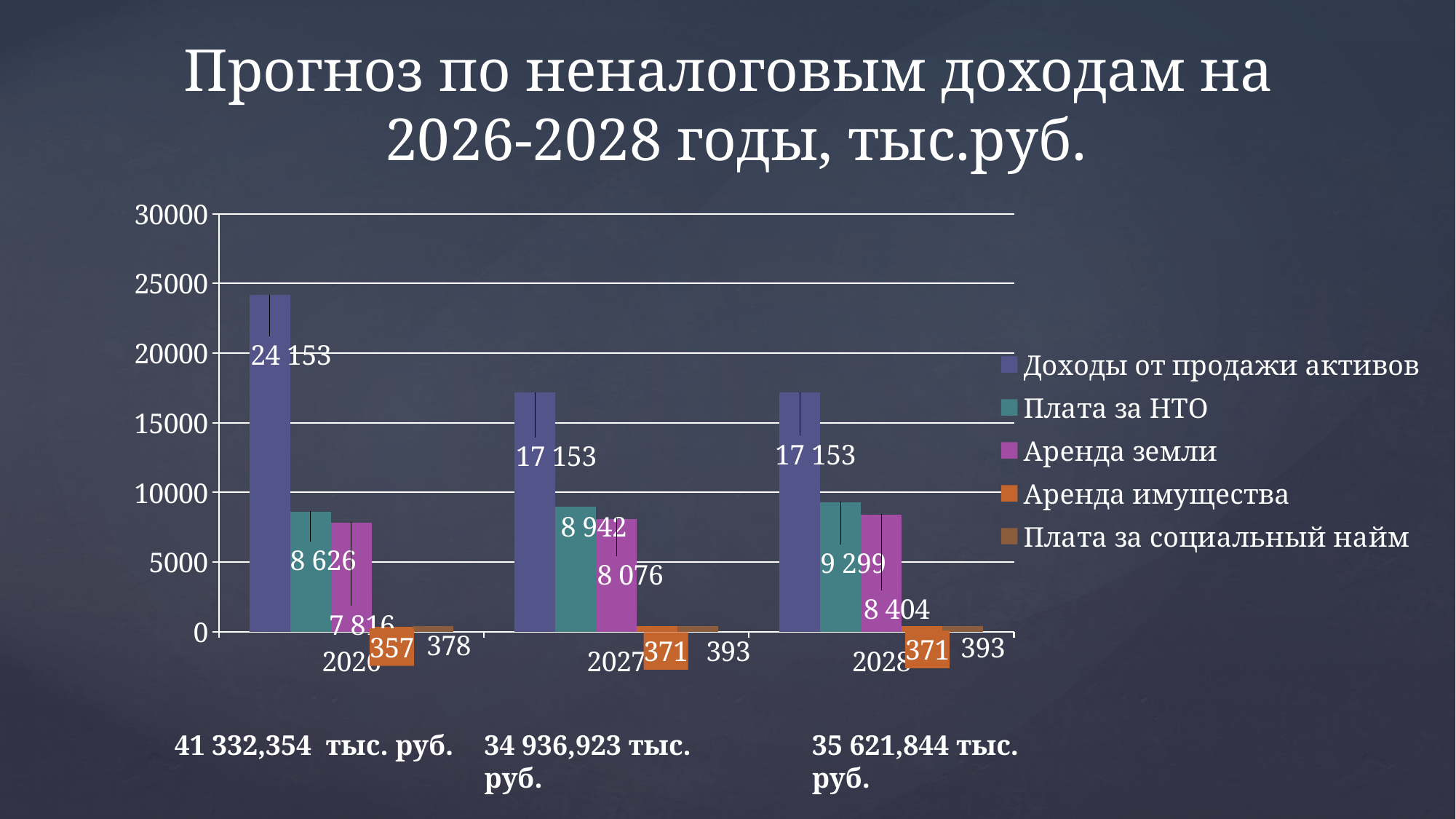
How many series does the legend list? 5 In which year is Плата за НТО lowest? 2026 What is the difference between Доходы от продажи активов in 2026 and in 2027? 7 000 What is the value for Аренда земли in 2027? 8 076 What is the value for Доходы от продажи активов in 2026? 24 153 What is the value for Плата за социальный найм in 2028? 393 What is the value for Аренда имущества in 2026? 357 What is the value for Плата за НТО in 2028? 9 299 What kind of chart is shown on the slide? Bar chart How many years are shown on the x axis? 3 Which is larger in 2027: Плата за НТО or Аренда земли? Плата за НТО In which year is Доходы от продажи активов highest? 2026